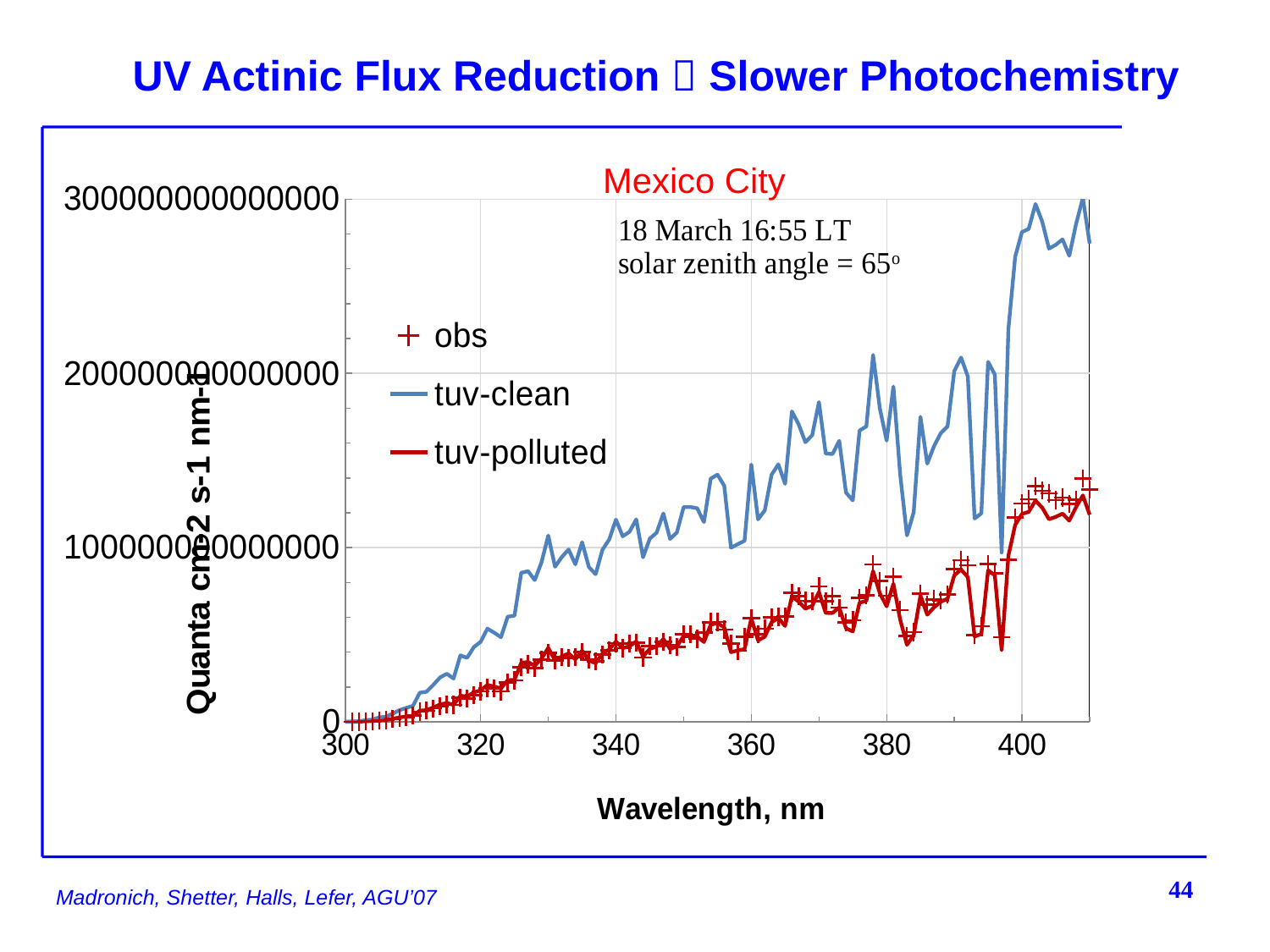
Do the values of tuv-polluted generally rise or fall as wavelength increases from 300 nm to 400 nm? rise How many labelled tick marks are on the x axis? 6 What is the title of the x axis? Wavelength, nm Which series reaches the highest values on the chart? tuv-clean At 380 nm, which series has the larger value, tuv-clean or tuv-polluted? tuv-clean How many series does the legend list? 3 Is the value of tuv-clean at 320 nm greater or less than 100000000000000? less Is the value of tuv-polluted at 360 nm greater or less than 100000000000000? less What kind of chart is shown on the slide? line chart Is the value of tuv-polluted at 400 nm greater or less than 100000000000000? greater What are the three series named in the legend? obs, tuv-clean, tuv-polluted